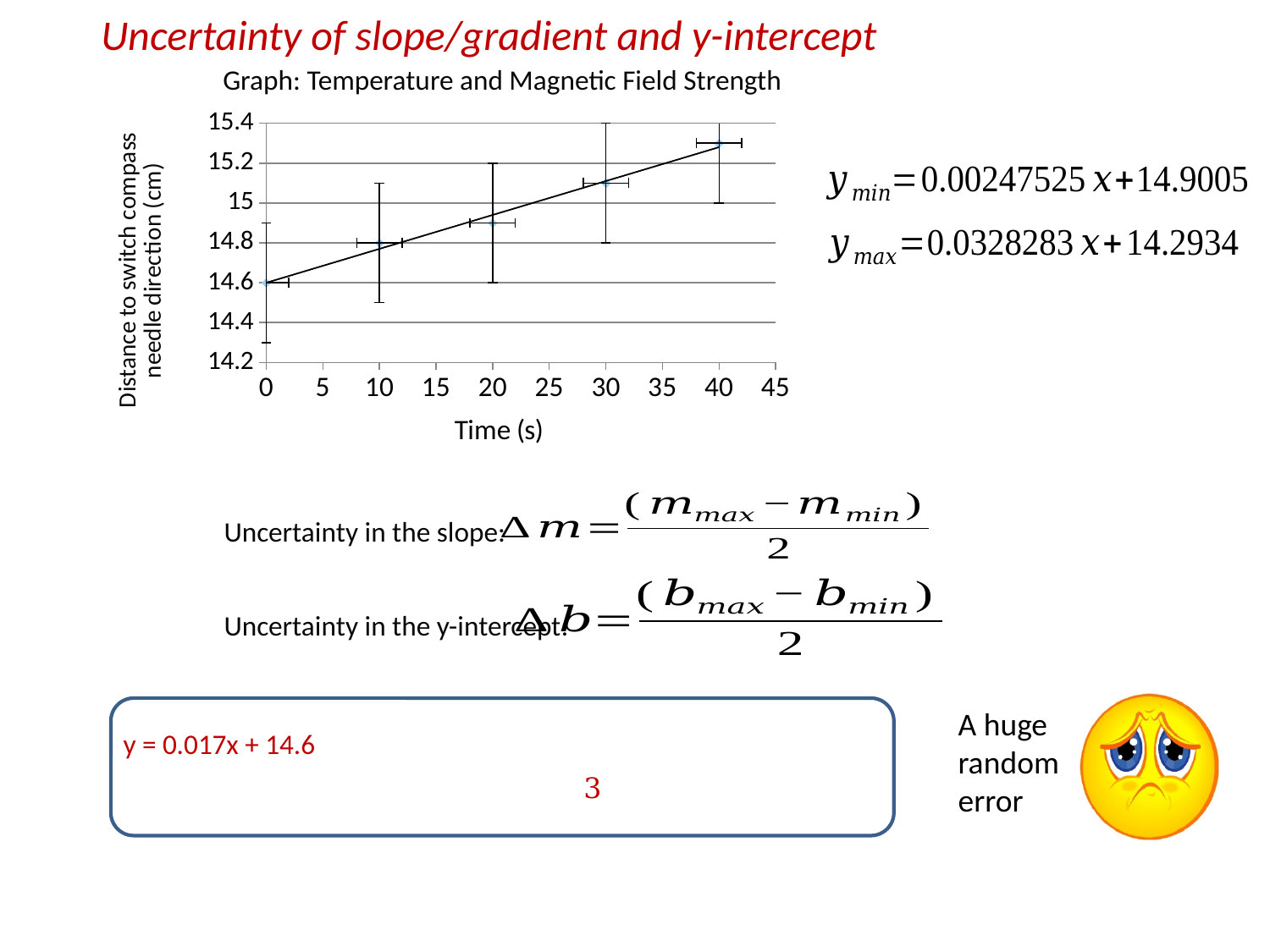
Is the value plotted at time 20 s greater or less than 15? less What is the title of the chart? Graph: Temperature and Magnetic Field Strength Do the plotted values rise or fall as time increases along the x axis? Rise Is the value plotted at time 30 s greater or less than 15? greater At which time is the plotted distance value lowest? 0 s At which time is the plotted distance value highest? 40 s What is the distance value plotted at time 0 s? 14.6 What is the distance value plotted at time 10 s? 14.8 Is the value plotted at time 40 s greater or less than 15.2? greater How many data points are plotted on the chart? 5 What kind of chart is shown on the slide? Scatter plot with error bars and a trend line What is the label of the x axis of the chart? Time (s)